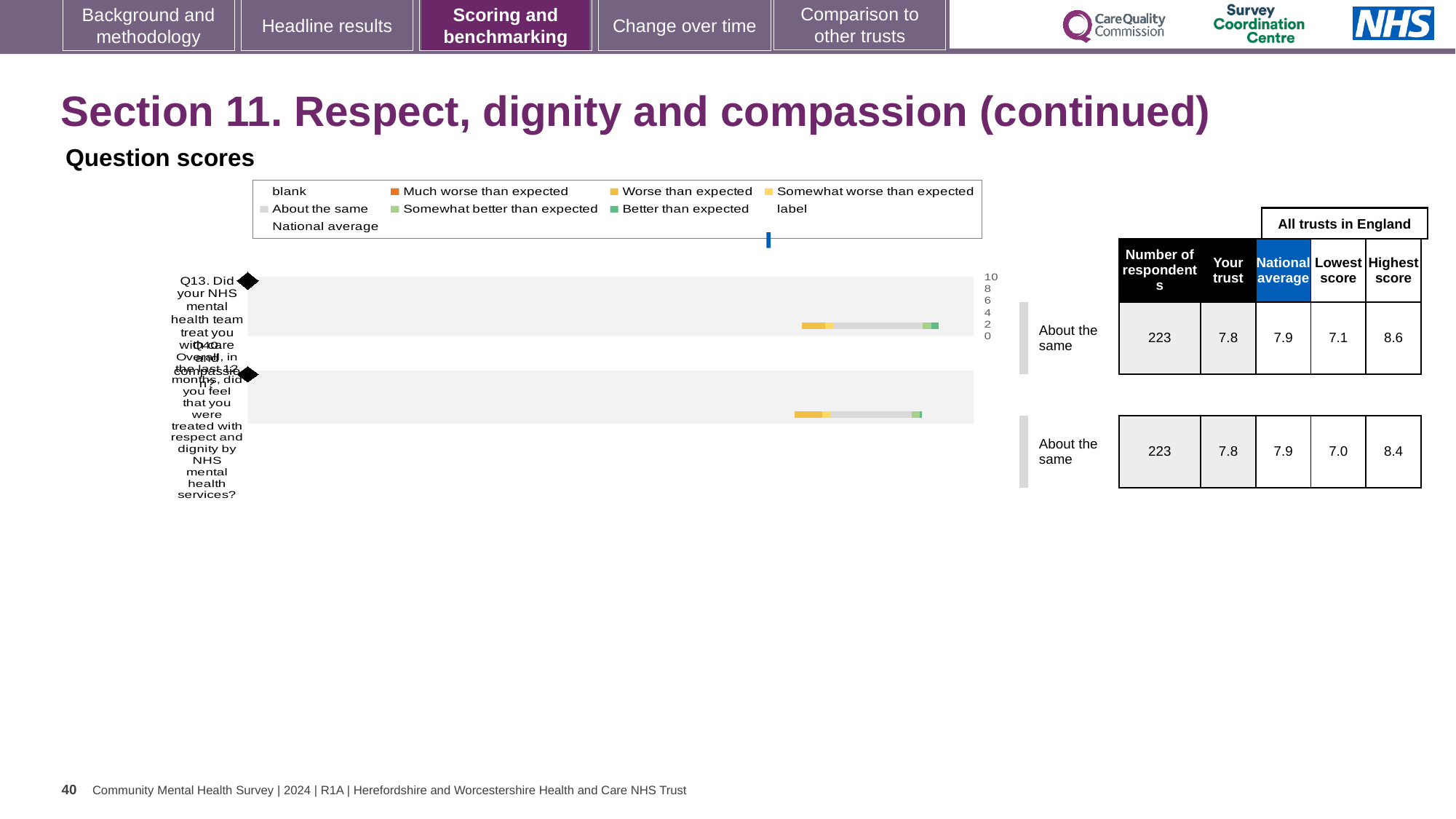
What type of chart is used to show the question scores on this slide? bar chart What is the lowest score among all trusts in England for Q14? 7.0 What is the national average score for Q14? 7.9 How many questions are plotted in the question scores chart? 2 What is the difference between the highest and lowest scores for Q14? 1.4 What is the difference between the highest and lowest scores for Q13? 1.5 What is the 'Your trust' score for Q13? 7.8 How many respondents answered Q13? 223 What benchmark category is shown for both Q13 and Q14? About the same What is the highest score among all trusts in England for Q13? 8.6 For Q14, which is larger, the 'Your trust' score or the national average? National average Which question has the higher highest score, Q13 or Q14? Q13